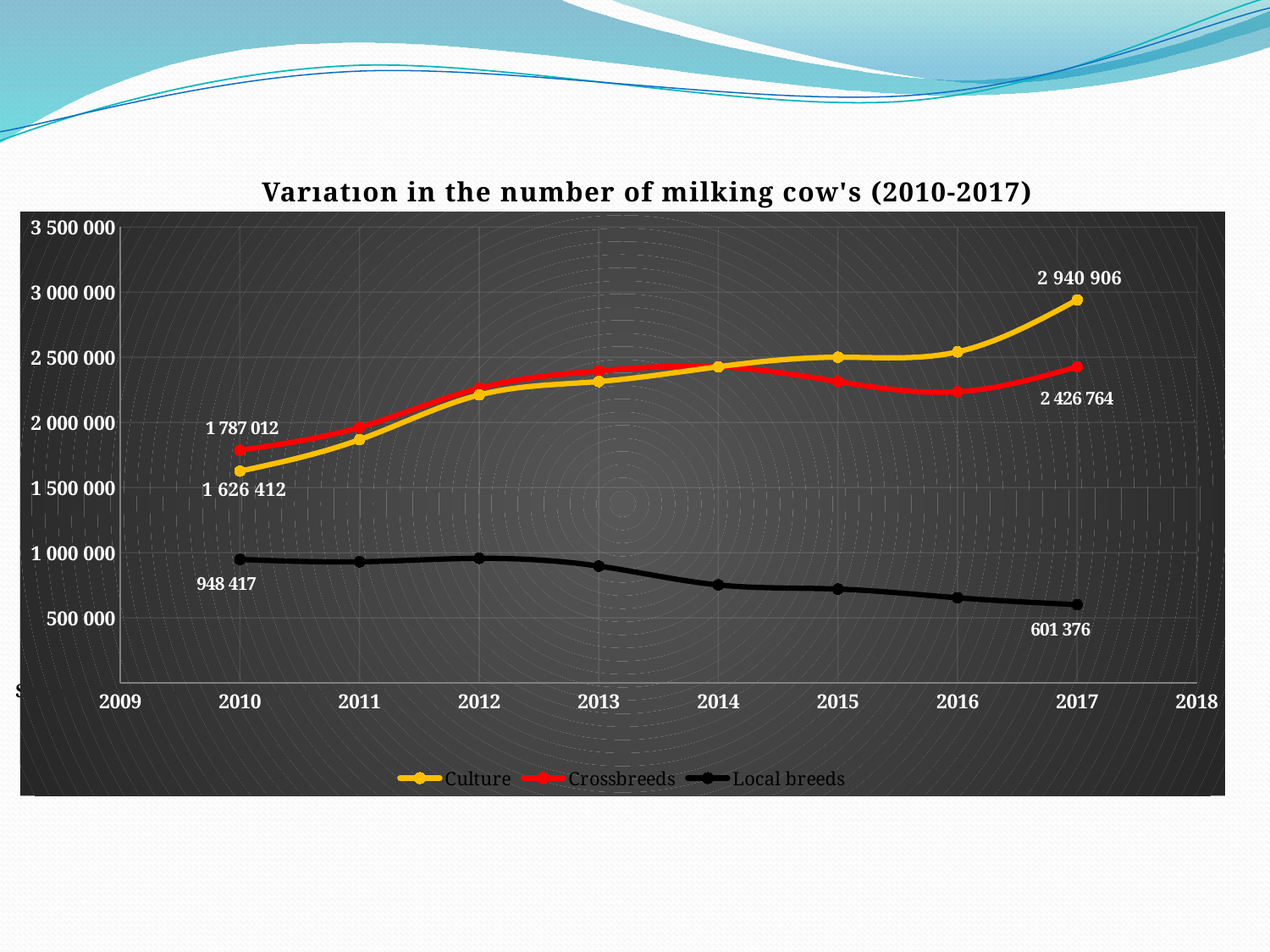
What is the value for Local breeds in 2017? 601 376 What is the value for Culture in 2017? 2 940 906 What is the value for Crossbreeds in 2010? 1 787 012 By how much did the Culture value increase from 2010 to 2017? 1 314 494 How many series does the legend list? 3 Is the value for Local breeds in 2014 greater or less than 1 000 000? less Do the values for Local breeds rise or fall from 2010 to 2017? fall Which series has the lowest value in 2010? Local breeds In 2017, which series has the larger value, Culture or Crossbreeds? Culture What is the value for Culture in 2010? 1 626 412 What kind of chart is shown on the slide? line chart By how much did the Local breeds value decrease from 2010 to 2017? 347 041